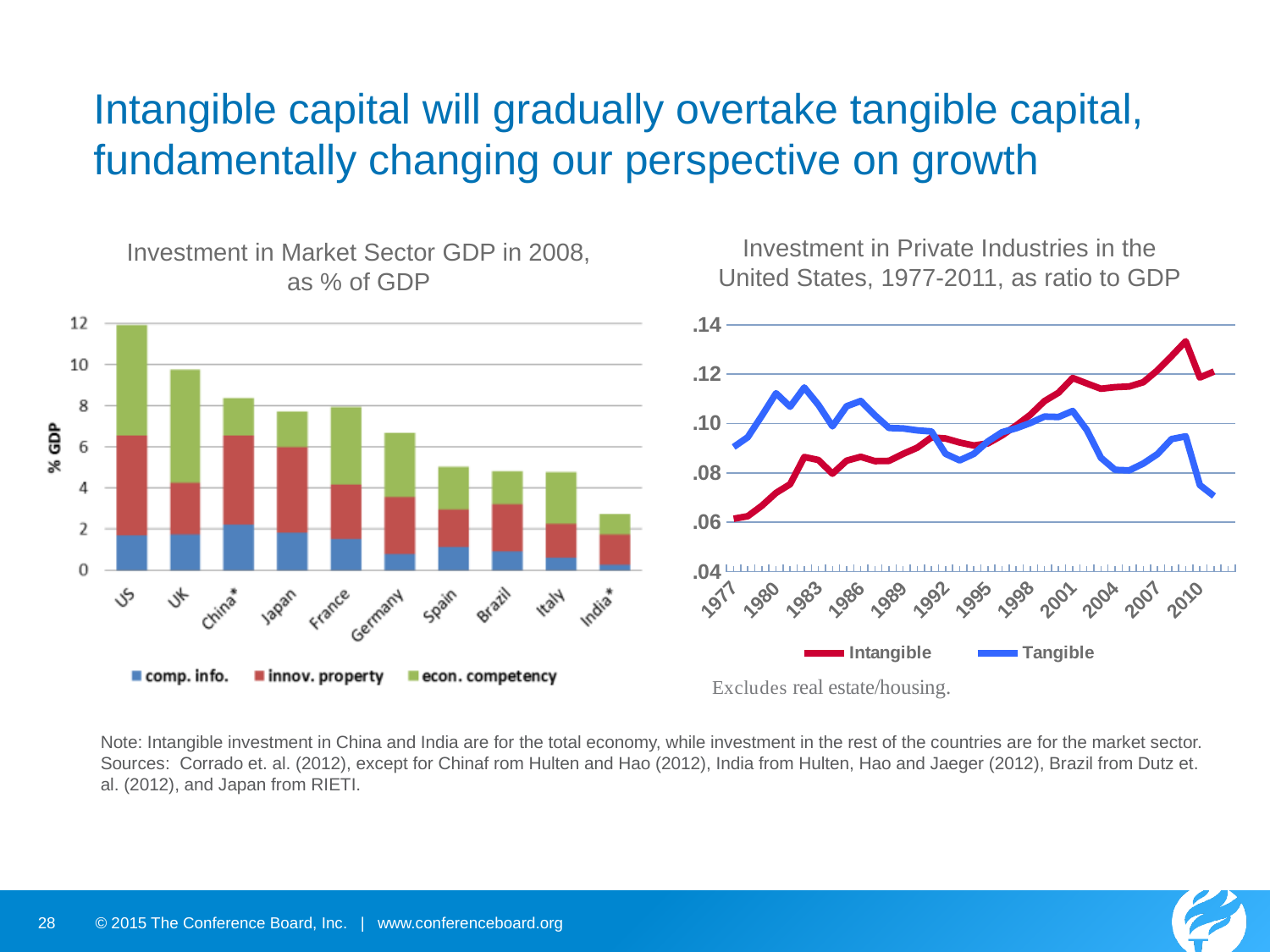
In the 'Investment in Market Sector GDP in 2008' chart, which country has the lowest total bar? India* In the 'Investment in Market Sector GDP in 2008' chart, is the total bar for the US greater or less than 10? greater In the 'Investment in Private Industries in the United States' chart, which series is higher in 2010, Intangible or Tangible? Intangible In the 'Investment in Private Industries in the United States' chart, is the Tangible value in 1977 greater or less than .10? less What kind of chart is the 'Investment in Private Industries in the United States, 1977-2011' chart? Line chart What kind of chart is the 'Investment in Market Sector GDP in 2008, as % of GDP' chart? Stacked bar chart In the 'Investment in Market Sector GDP in 2008' chart, which country has the highest total bar? US In the 'Investment in Market Sector GDP in 2008' chart, how many countries are shown on the x axis? 10 How many series does the legend of the 'Investment in Private Industries in the United States' chart list? 2 How many series does the legend of the 'Investment in Market Sector GDP in 2008' chart list? 3 In the 'Investment in Market Sector GDP in 2008' chart, is the total bar for Germany greater or less than 8? less In the 'Investment in Private Industries in the United States' chart, does the Intangible line generally rise or fall from 1977 to 2011? Rise